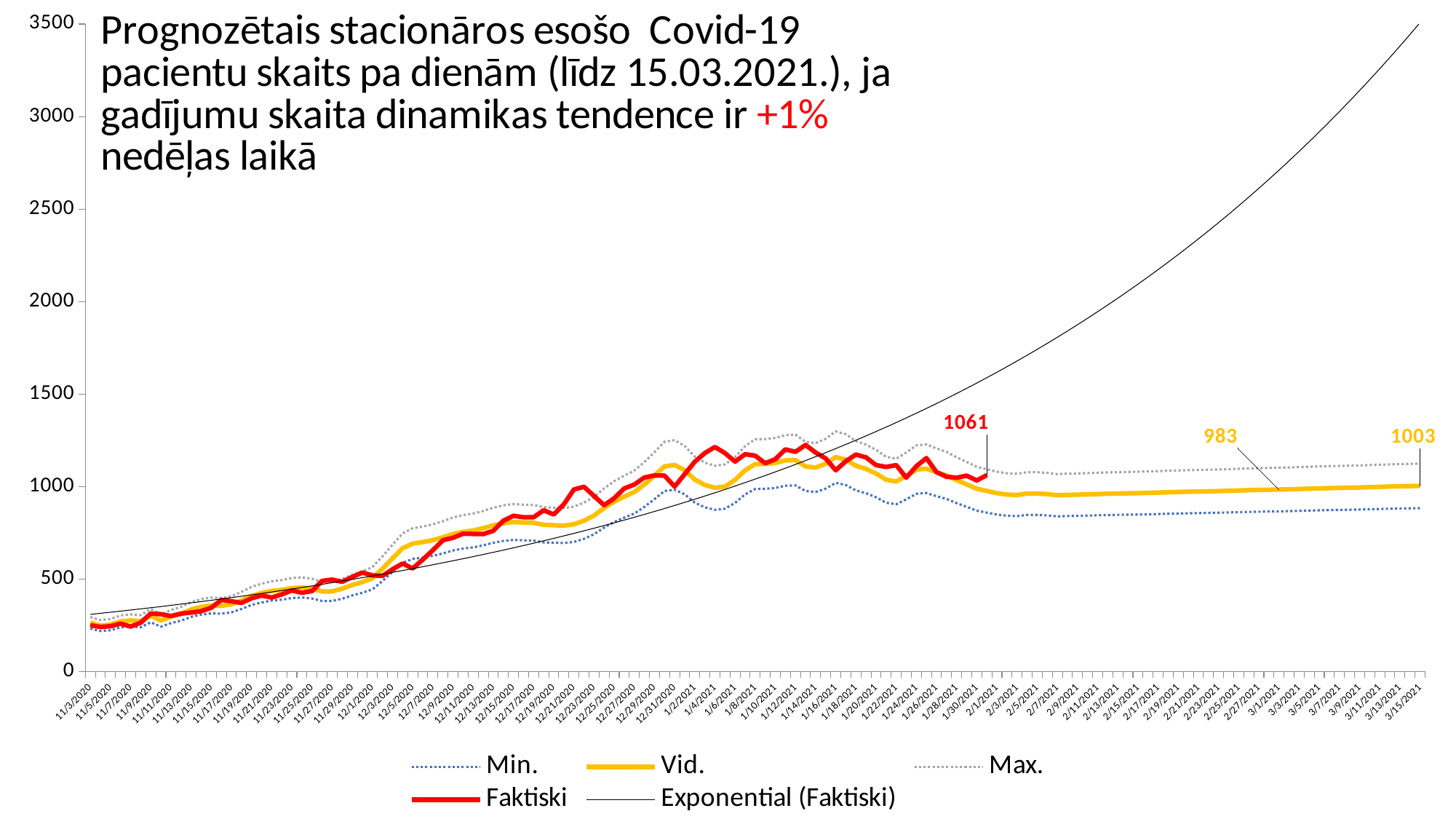
What is the difference between the labelled Faktiski value 1061 and the Vid. value 1003 at 3/15/2021? 58 What kind of chart is shown on the slide? line chart How many series does the legend list? 5 Is the value of the Exponential (Faktiski) line at 3/15/2021 greater or less than 3000? greater Which series reaches the highest value at 3/15/2021? Exponential (Faktiski) What value is labelled on the Vid. line at 3/15/2021? 1003 What percentage weekly trend is stated in the chart title? +1% Is the value of the Min. line at 3/15/2021 greater or less than 1000? less What is the value printed at the end of the Faktiski (red) line? 1061 Which is larger: the labelled Faktiski value or the Vid. value labelled at 3/15/2021? Faktiski (1061) What is the lower of the two values labelled on the Vid. (yellow) line? 983 Does the Exponential (Faktiski) line rise or fall along the x axis? rise